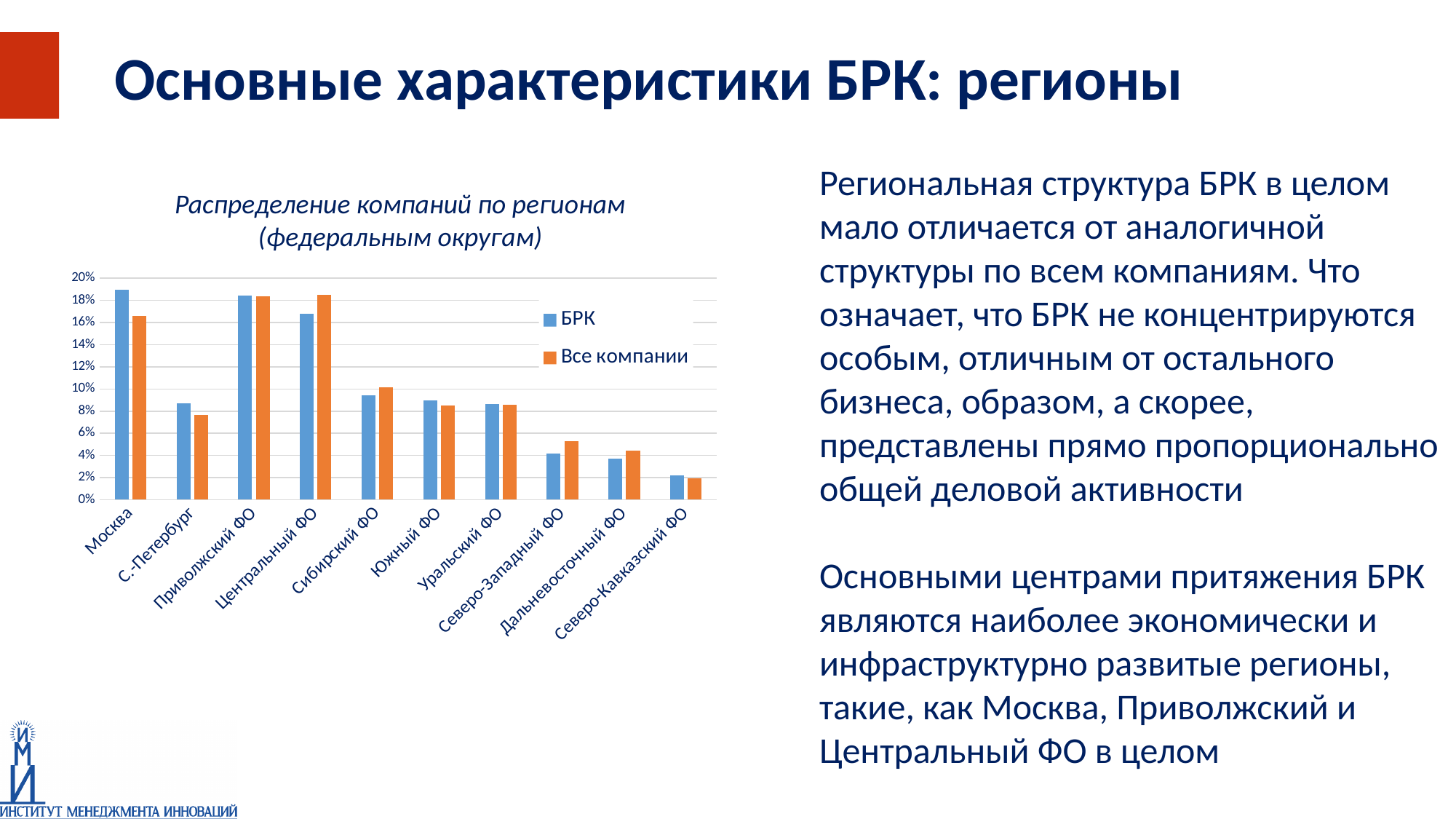
How many regions (categories) are shown on the x axis of the chart? 10 Which region has the lowest value for the БРК series? Северо-Кавказский ФО For Центральный ФО, which series has the larger value: БРК or Все компании? Все компании For Москва, which series has the larger value: БРК or Все компании? БРК What kind of chart is shown on the slide? Bar chart Is the БРК value for Центральный ФО greater or less than 18%? less What is the title of the chart? Распределение компаний по регионам (федеральным округам) Is the БРК value for Москва greater or less than 18%? greater Is the БРК value for Дальневосточный ФО greater or less than 4%? less How many series does the chart legend list? 2 Which region has the lowest value for the Все компании series? Северо-Кавказский ФО